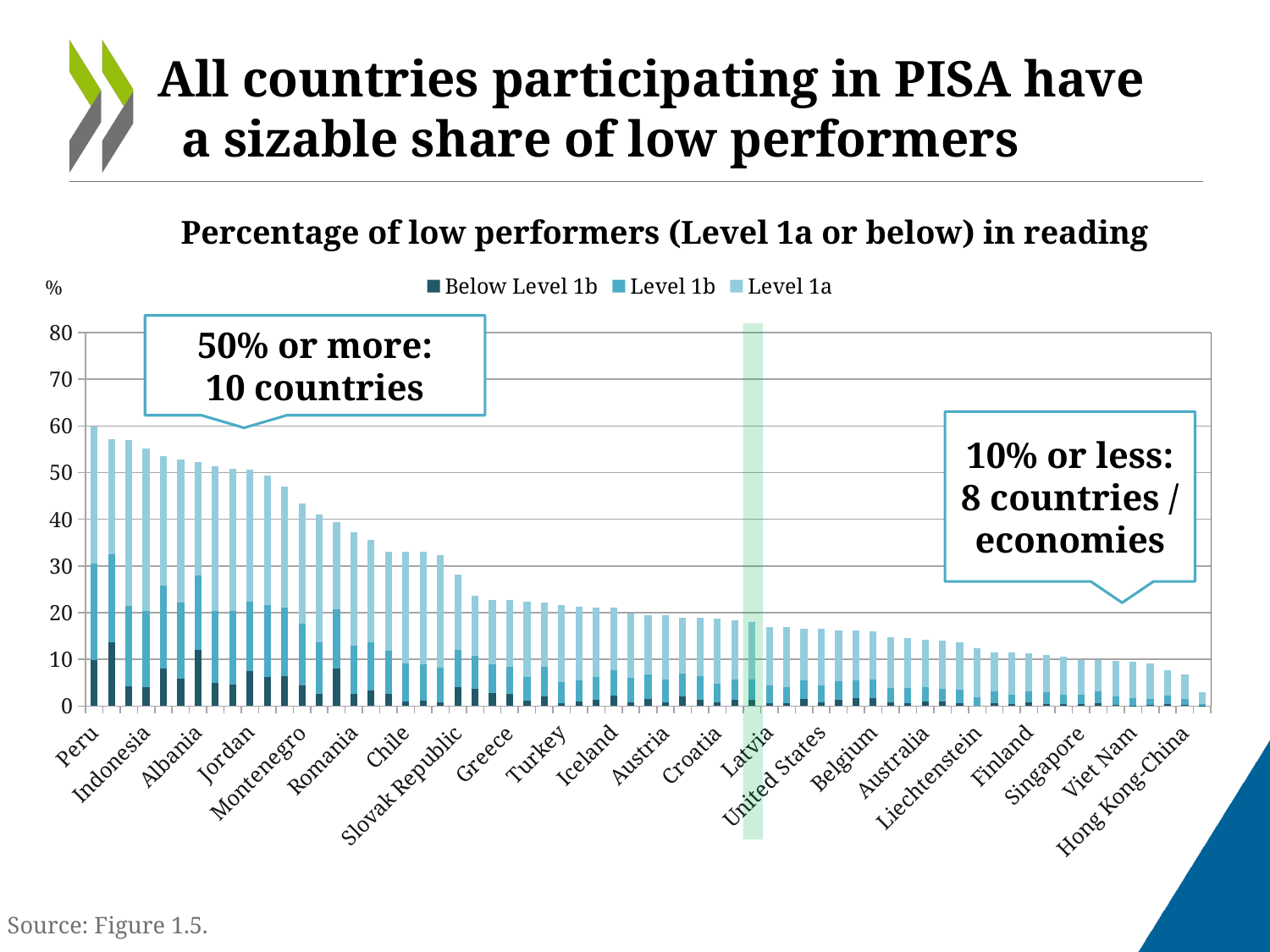
Do the bar totals rise or fall from left to right along the x axis? fall Is the total value for Slovak Republic greater or less than 30? less Is the total value for Hong Kong-China greater or less than 10? less Is the total value for United States greater or less than 20? less How many series does the legend list? 3 Which has a larger share of low performers, Indonesia or Chile? Indonesia What kind of chart is shown on the slide? Stacked bar chart According to the annotation, how many countries have 50% or more low performers? 10 countries Which country has the highest percentage of low performers in reading? Peru What is the title of the chart? Percentage of low performers (Level 1a or below) in reading